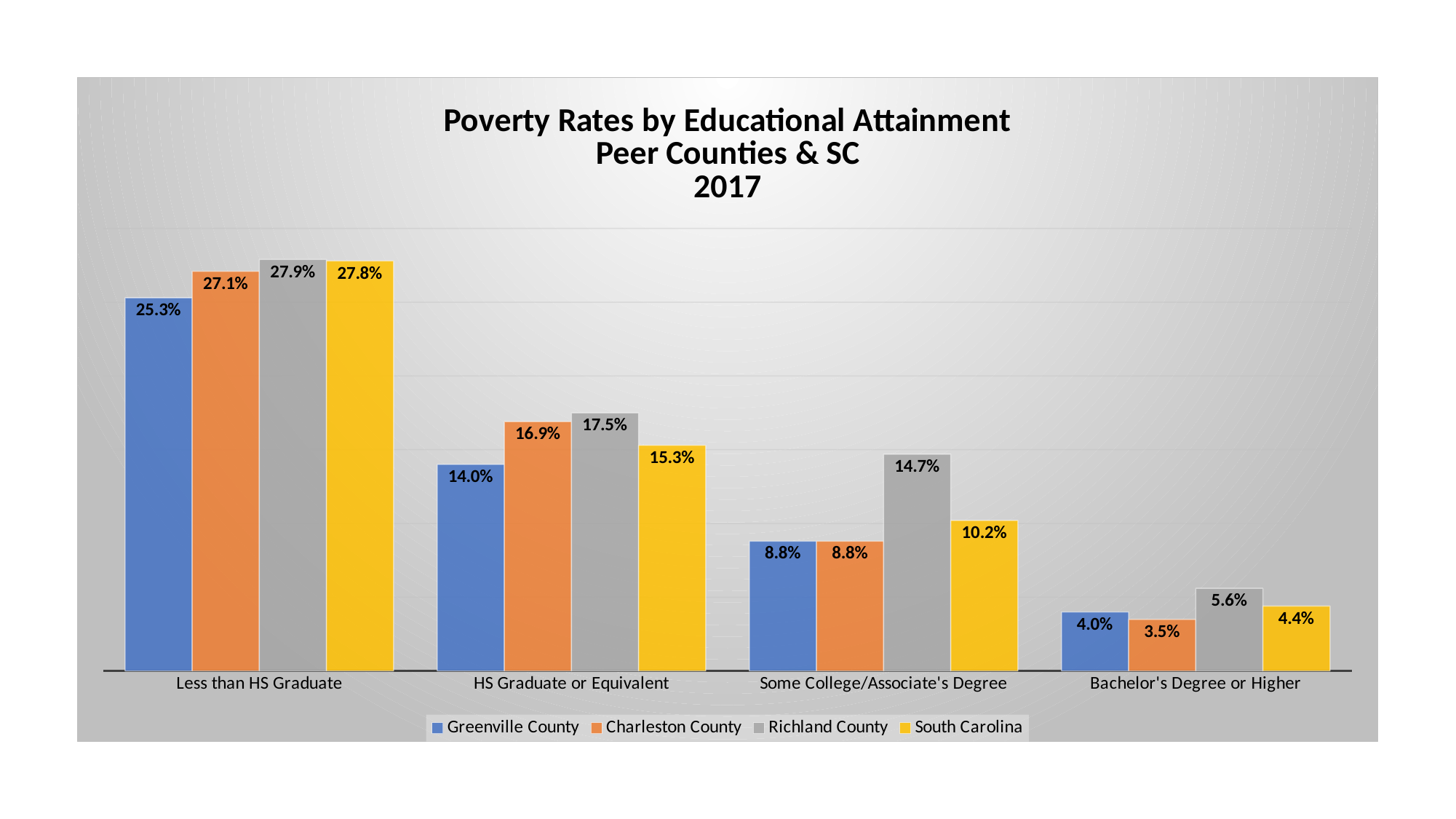
What kind of chart is shown on the slide? Bar chart What is the poverty rate for Greenville County among those with less than a HS graduate education? 25.3% Which series has the lowest poverty rate in the HS Graduate or Equivalent category? Greenville County How many educational attainment categories are shown on the x axis? 4 Which is larger in the Bachelor's Degree or Higher category: Greenville County or Charleston County? Greenville County What is the poverty rate for South Carolina in the HS Graduate or Equivalent category? 15.3% What is the difference between Richland County's and Greenville County's poverty rates in the Less than HS Graduate category? 2.6% Which series has the highest poverty rate in the Bachelor's Degree or Higher category? Richland County How many series does the legend list? 4 What year is shown in the chart title? 2017 Do the poverty rates for South Carolina rise or fall as educational attainment increases along the x axis? Fall What is the poverty rate for Richland County in the Some College/Associate's Degree category? 14.7%